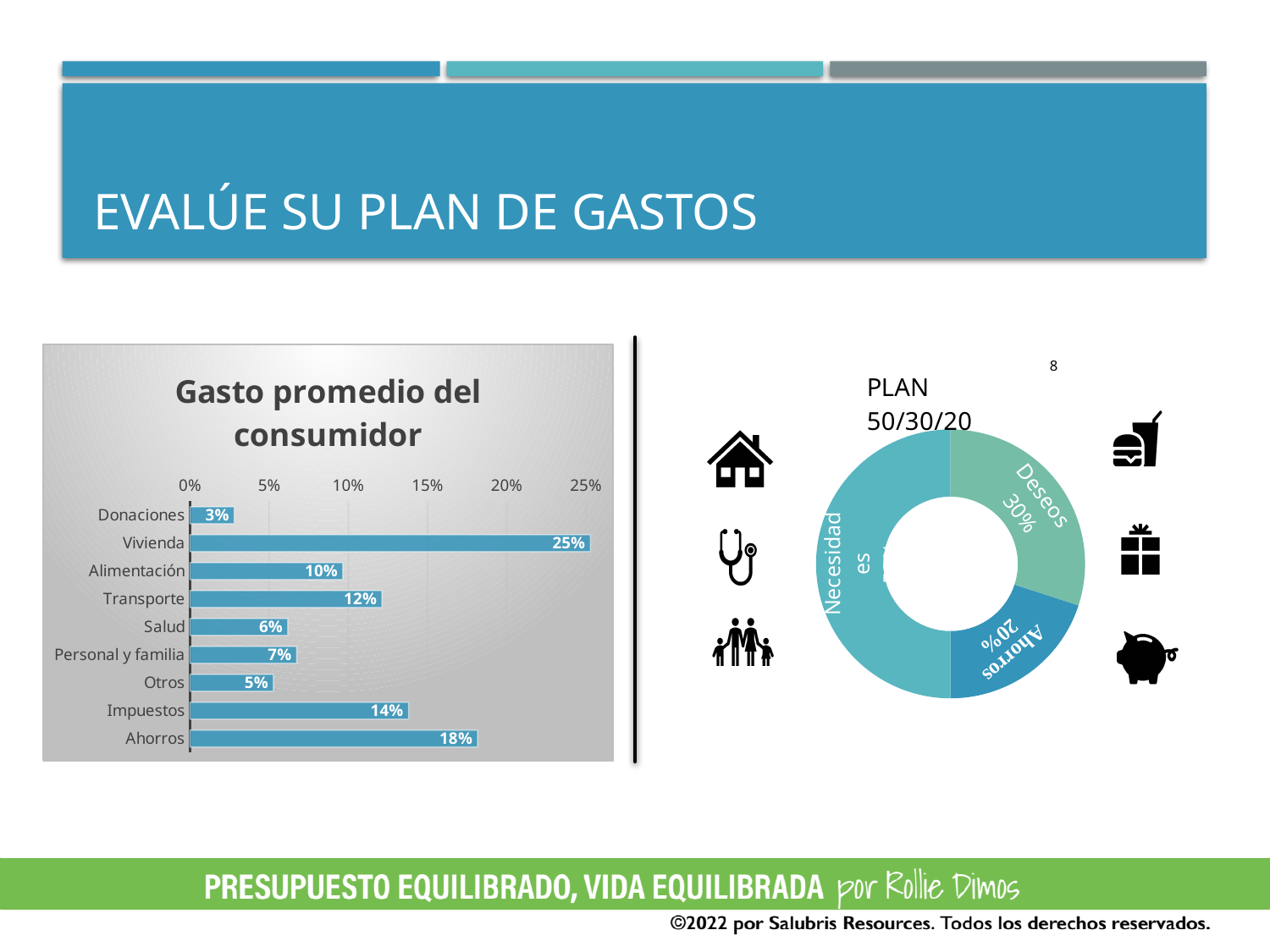
What kind of chart is 'Gasto promedio del consumidor'? Bar chart In the 'Gasto promedio del consumidor' chart, which is larger, Transporte or Personal y familia? Transporte What kind of chart is the 'PLAN 50/30/20' chart on the right? Doughnut chart In the 'Gasto promedio del consumidor' chart, how many categories are shown? 9 In the 'Gasto promedio del consumidor' chart, what is the value for Impuestos? 14% In the 'PLAN 50/30/20' chart on the right, what share is labelled for Ahorros? 20% In the 'Gasto promedio del consumidor' chart, which category has the highest value? Vivienda In the 'Gasto promedio del consumidor' chart, what is the difference between Vivienda and Alimentación? 15% In the 'Gasto promedio del consumidor' chart, which category has the lowest value? Donaciones In the 'Gasto promedio del consumidor' chart, what is the value for Vivienda? 25% In the 'PLAN 50/30/20' chart on the right, what share is labelled for Deseos? 30% In the 'Gasto promedio del consumidor' chart, what is the value for Ahorros? 18%